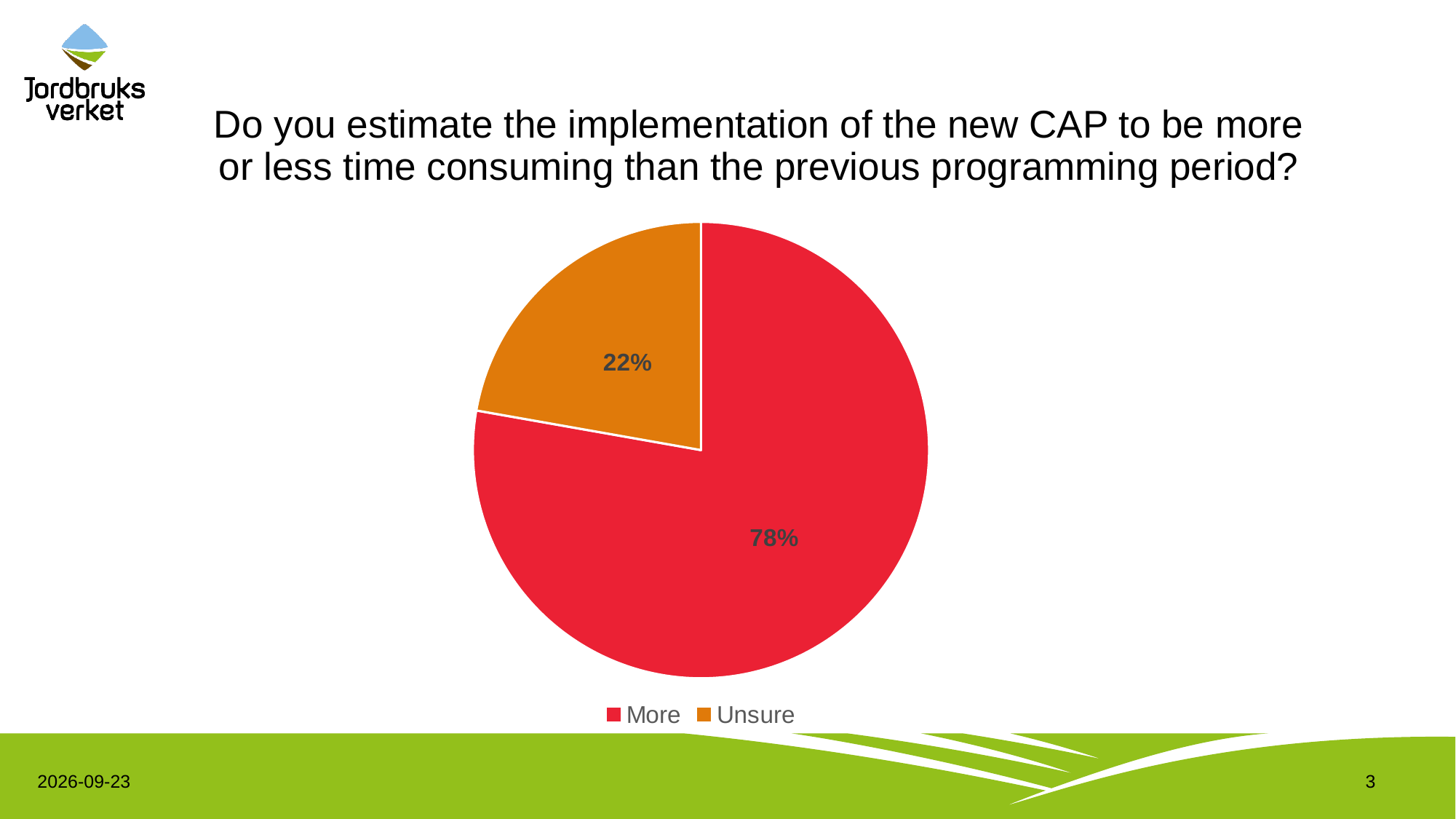
Which slice is the largest? More How many entries does the legend list? 2 What colour is the "Unsure" slice? orange What share of the pie does "More" represent? 78% What share of the pie does "Unsure" represent? 22% What is the difference in percentage points between the "More" and "Unsure" slices? 56 What kind of chart is shown on the slide? pie chart How many slices does the pie chart have? 2 Which is larger, the "More" slice or the "Unsure" slice? More Which slice is the smallest? Unsure What is the title of the chart? Do you estimate the implementation of the new CAP to be more or less time consuming than the previous programming period?